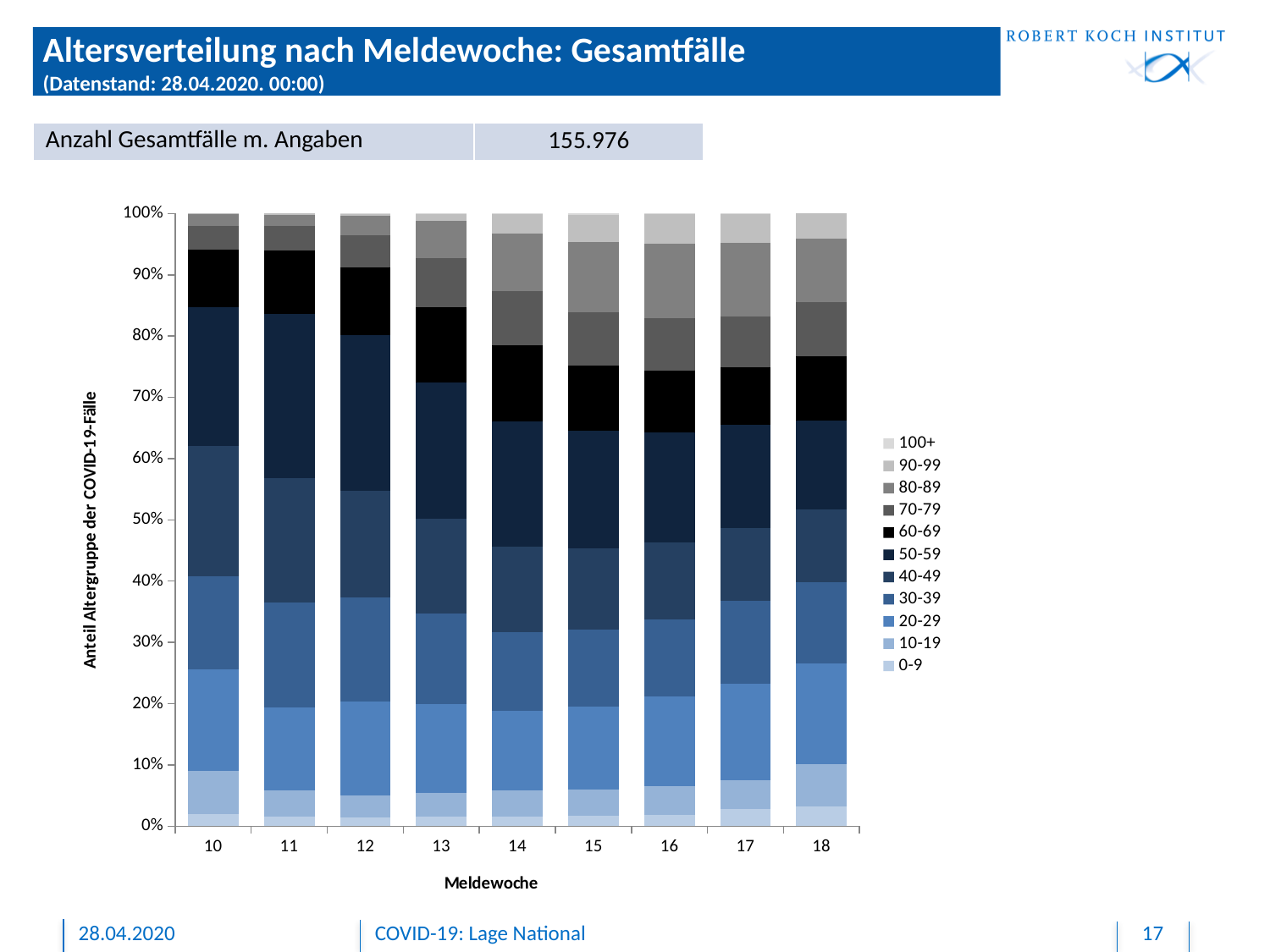
Does the share of the 40-49 age group rise or fall from week 10 to week 18? fall What is the title of the chart slide? Altersverteilung nach Meldewoche: Gesamtfälle Does the combined share of the age groups 70 and older rise or fall from week 10 to week 18? rise How many reporting weeks (Meldewochen) are shown on the x axis of the chart? 9 In week 10, which segment is larger: the 40-49 age group or the 0-9 age group? 40-49 What does each stacked bar in the chart add up to? 100% How many age groups does the chart legend list? 11 Is the share of the 0-9 age group in week 10 greater or less than 10%? less What kind of chart is shown on the slide? stacked bar chart What is the last reporting week shown on the x axis? 18 What is the first reporting week shown on the x axis? 10 What number is given for 'Anzahl Gesamtfälle m. Angaben' on the slide? 155.976